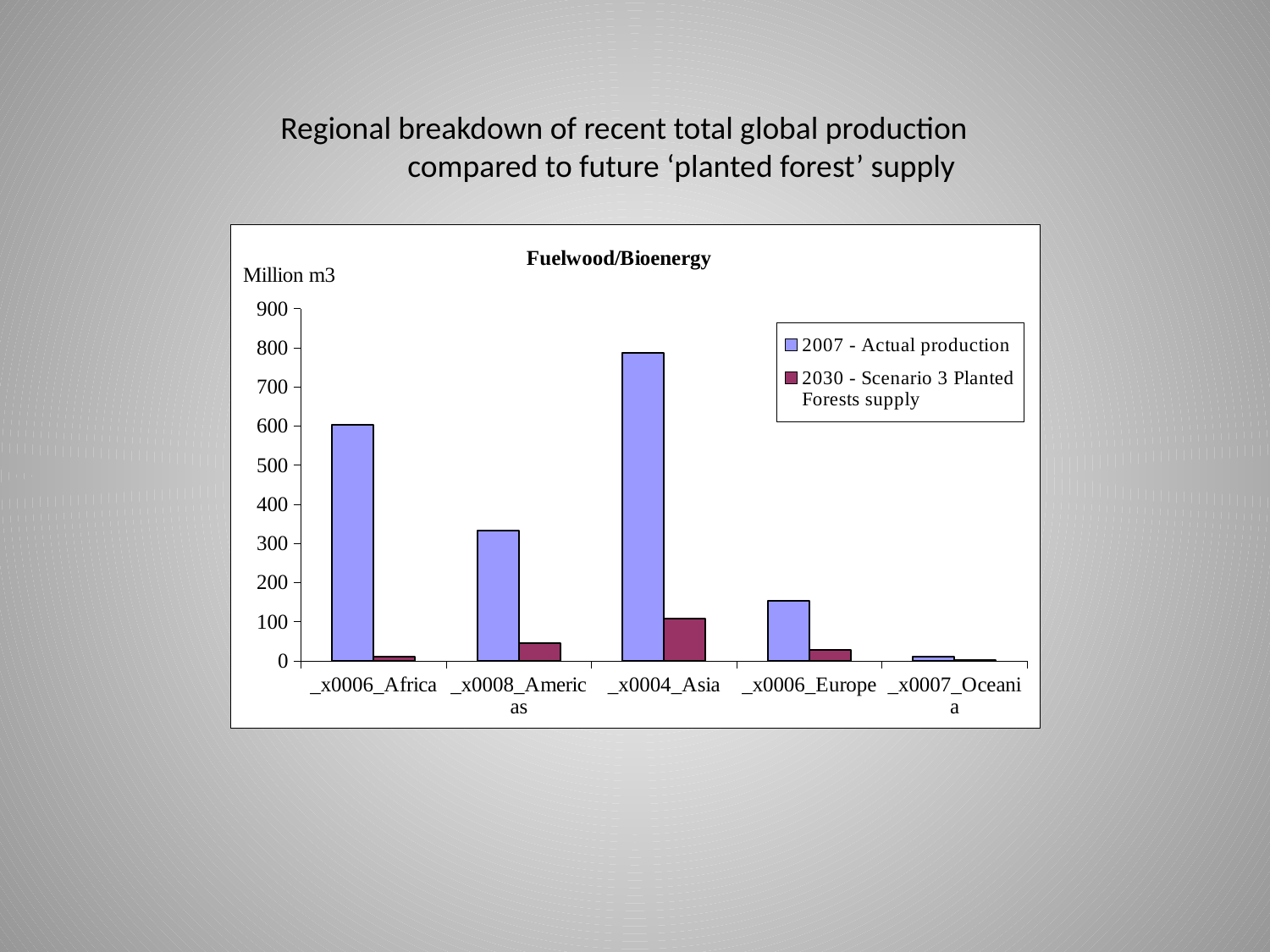
Which is larger for the Americas: the 2007 - Actual production value or the 2030 - Scenario 3 Planted Forests supply value? 2007 - Actual production What is the title of the chart? Fuelwood/Bioenergy What unit is shown for the chart's vertical axis? Million m3 How many series does the chart legend list? 2 Which region has the highest 2030 - Scenario 3 Planted Forests supply value? Asia Which region has the lowest 2007 - Actual production value? Oceania Is the 2007 - Actual production value for Africa greater or less than 500? greater What kind of chart is shown on the slide? bar chart Is the 2007 - Actual production value for Europe greater or less than 200? less Is the 2007 - Actual production value for Asia greater or less than 700? greater How many regions are shown on the x axis of the chart? 5 Which region has the highest 2007 - Actual production value? Asia